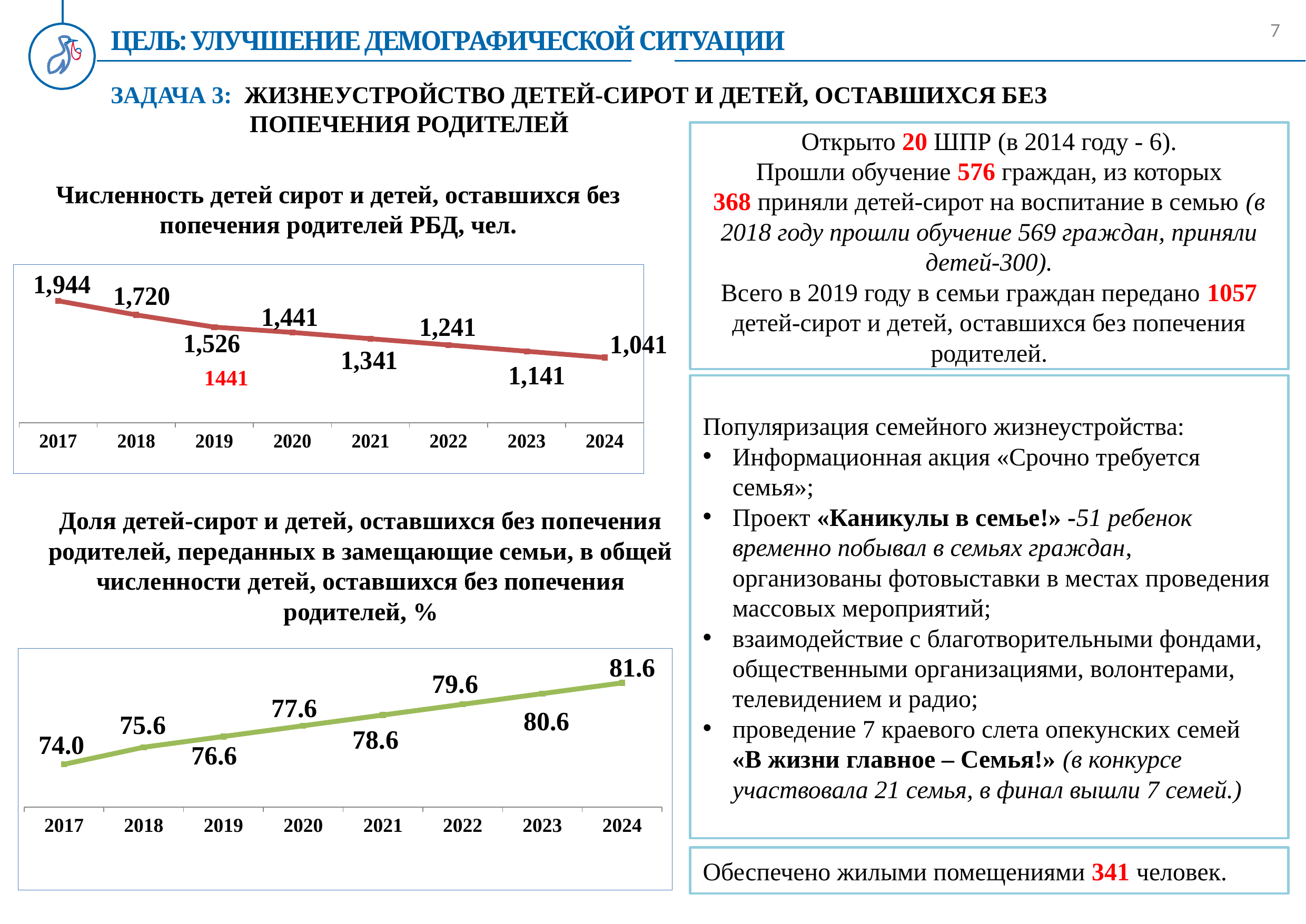
In the top chart (Численность детей сирот...), what is the difference between the 2017 and 2018 values? 224 What type of chart is the top chart (Численность детей сирот...)? line chart In the top chart (Численность детей сирот...), how many years are plotted? 8 In the bottom chart (Доля детей-сирот..., %), which year has the highest value? 2024 In the bottom chart (Доля детей-сирот..., %), which is larger: the value for 2018 or the value for 2023? 2023 In the bottom chart (Доля детей-сирот..., %), what is the difference between the 2024 and 2017 values? 7.6 In the bottom chart (Доля детей-сирот..., %), what is the value for 2020? 77.6 In the bottom chart (Доля детей-сирот..., %), what is the value for 2024? 81.6 In the top chart (Численность детей сирот...), what is the value for 2021? 1,341 In the top chart (Численность детей сирот...), which year has the lowest value? 2024 In the top chart (Численность детей сирот и детей, оставшихся без попечения родителей РБД, чел.), what is the value for 2017? 1,944 In the top chart (Численность детей сирот...), do the values rise or fall from 2017 to 2024? fall